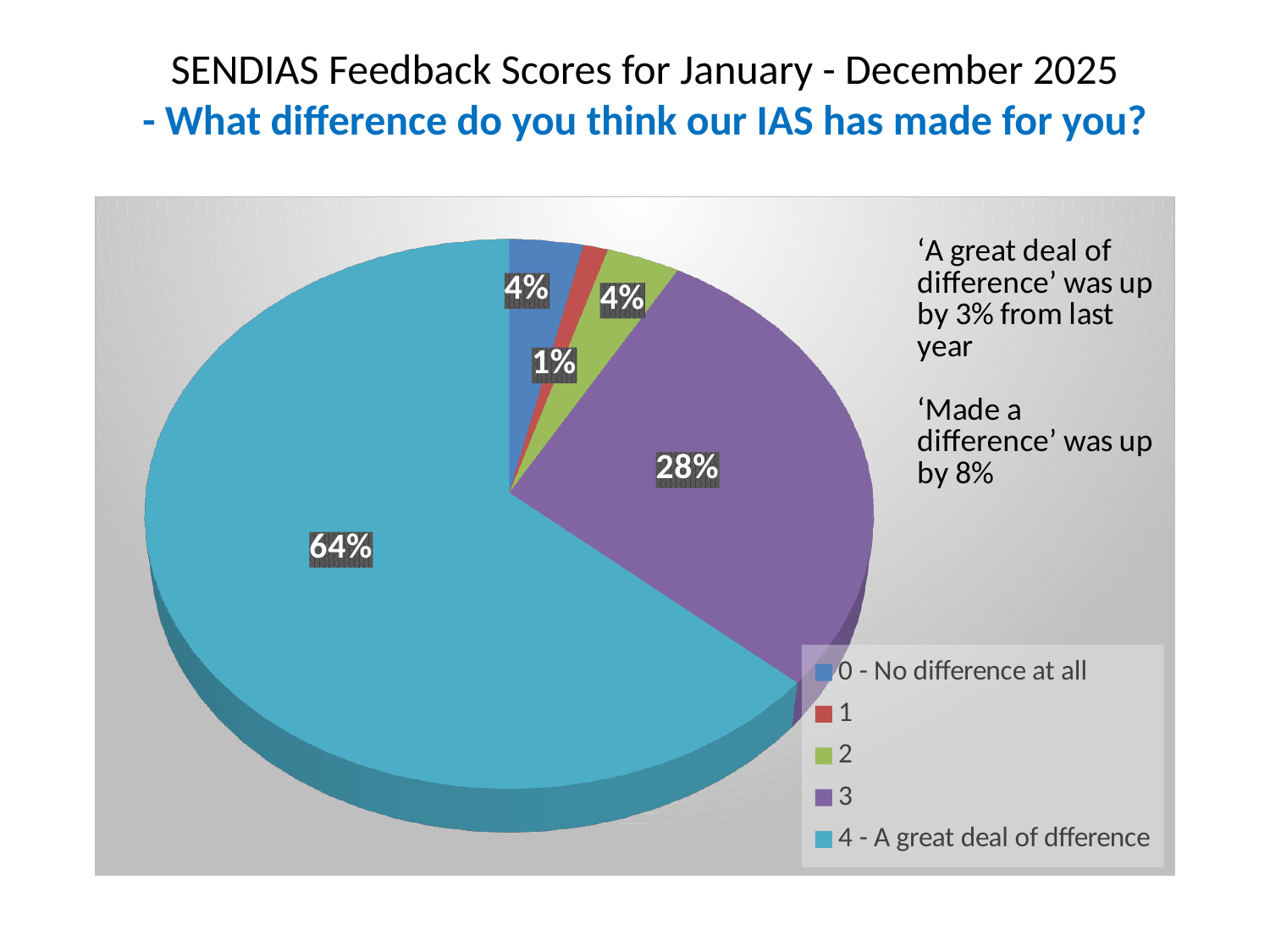
What kind of chart is shown on the slide? Pie chart What colour is the slice for '4 - A great deal of dfference'? Teal (light blue) Which slice is larger, category '3' or '0 - No difference at all'? 3 How many categories does the pie chart show? 5 What share of the pie does category '3' take? 28% What share of the pie does category '2' take? 4% What is the difference in percentage points between the slices for '4 - A great deal of dfference' and '3'? 36% What share of the pie does '4 - A great deal of dfference' take? 64% Which category has the largest slice of the pie? 4 - A great deal of dfference Which category has the smallest slice of the pie? 1